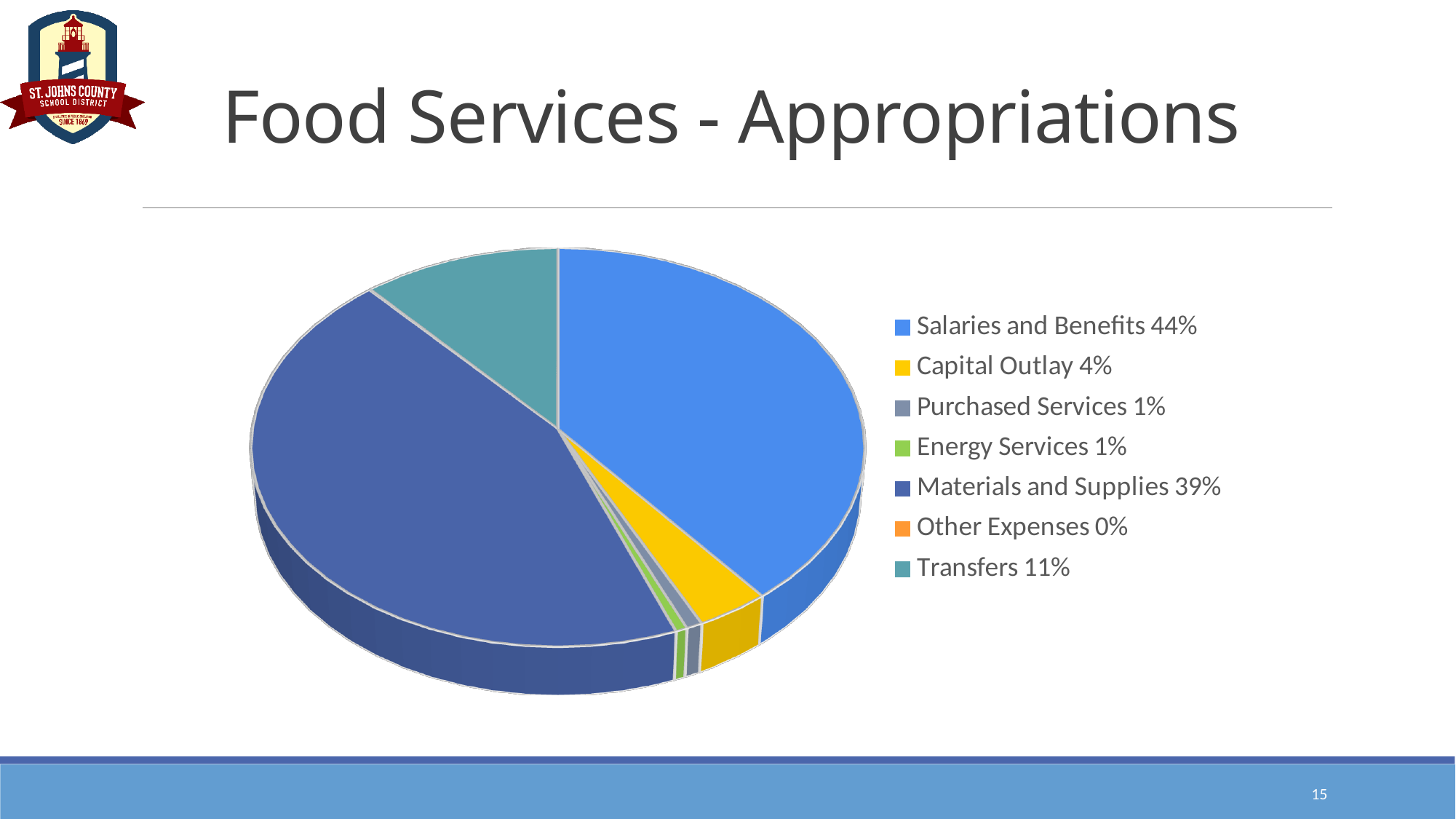
Which category has the largest share of appropriations? Salaries and Benefits What percentage is shown for Other Expenses? 0% What percentage of appropriations is Transfers? 11% Which category has the smallest share of appropriations? Other Expenses What type of chart is shown on the slide? Pie chart What percentage of appropriations is Materials and Supplies? 39% What is the title of the chart slide? Food Services - Appropriations What percentage of appropriations is Capital Outlay? 4% How many categories does the legend list? 7 What is the difference in percentage points between Salaries and Benefits and Materials and Supplies? 5 Which is larger, Transfers or Capital Outlay? Transfers What share of Food Services appropriations goes to Salaries and Benefits? 44%